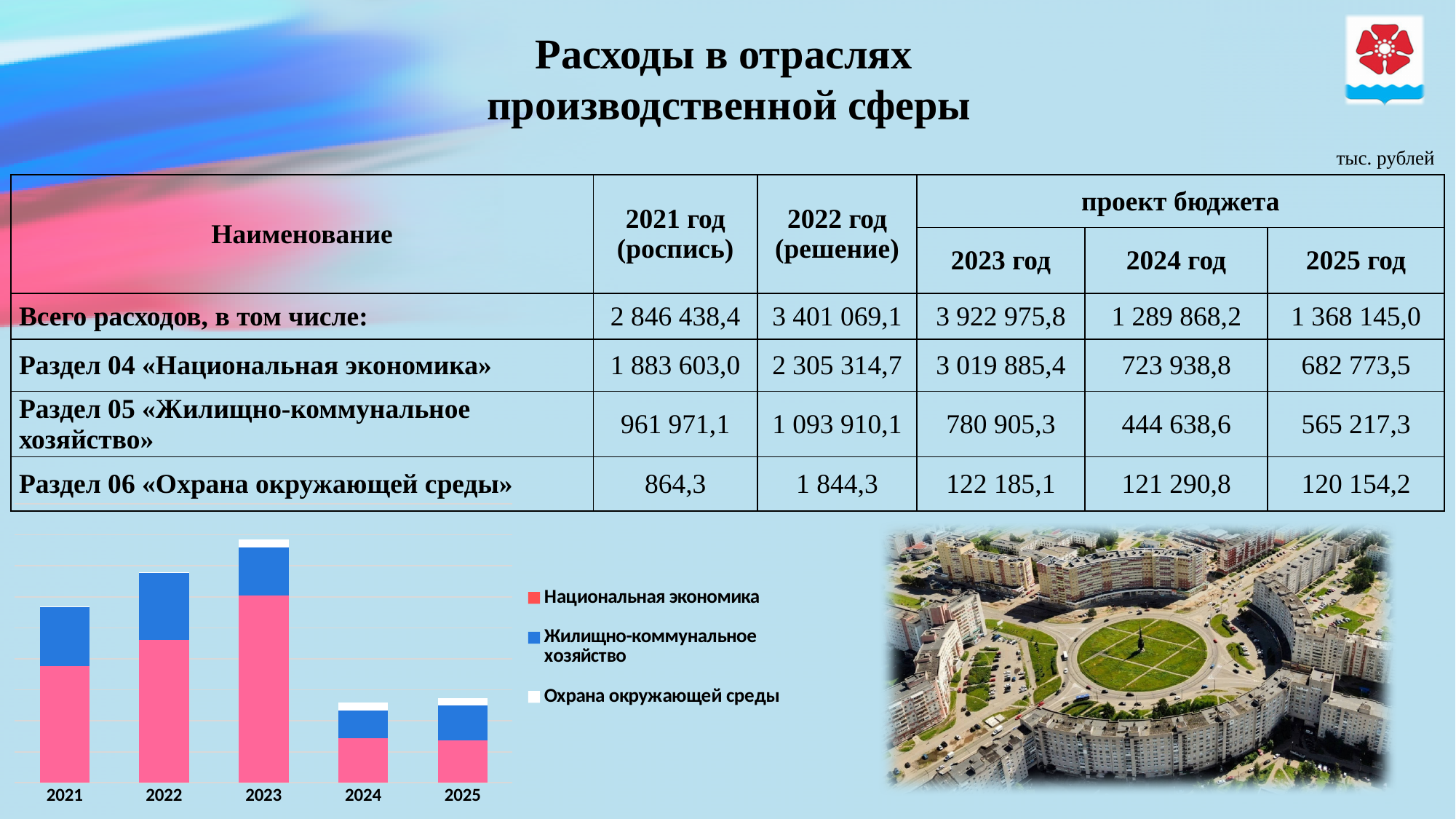
How many years (bars) are shown on the x axis of the bar chart? 5 How many series does the legend of the bar chart list? 3 Do the stacked bar totals rise or fall from 2023 to 2024? fall What colour represents Жилищно-коммунальное хозяйство in the bar chart? blue Which series is shown in pink in the bar chart legend? Национальная экономика Do the stacked bar totals rise or fall from 2021 to 2023? rise Which stacked bar is taller in the chart, 2021 or 2023? 2023 Which series is the largest segment of the 2023 bar? Национальная экономика Which year has the tallest stacked bar in the chart? 2023 What kind of chart is shown at the bottom left of the slide? bar chart Which stacked bar is taller in the chart, 2022 or 2024? 2022